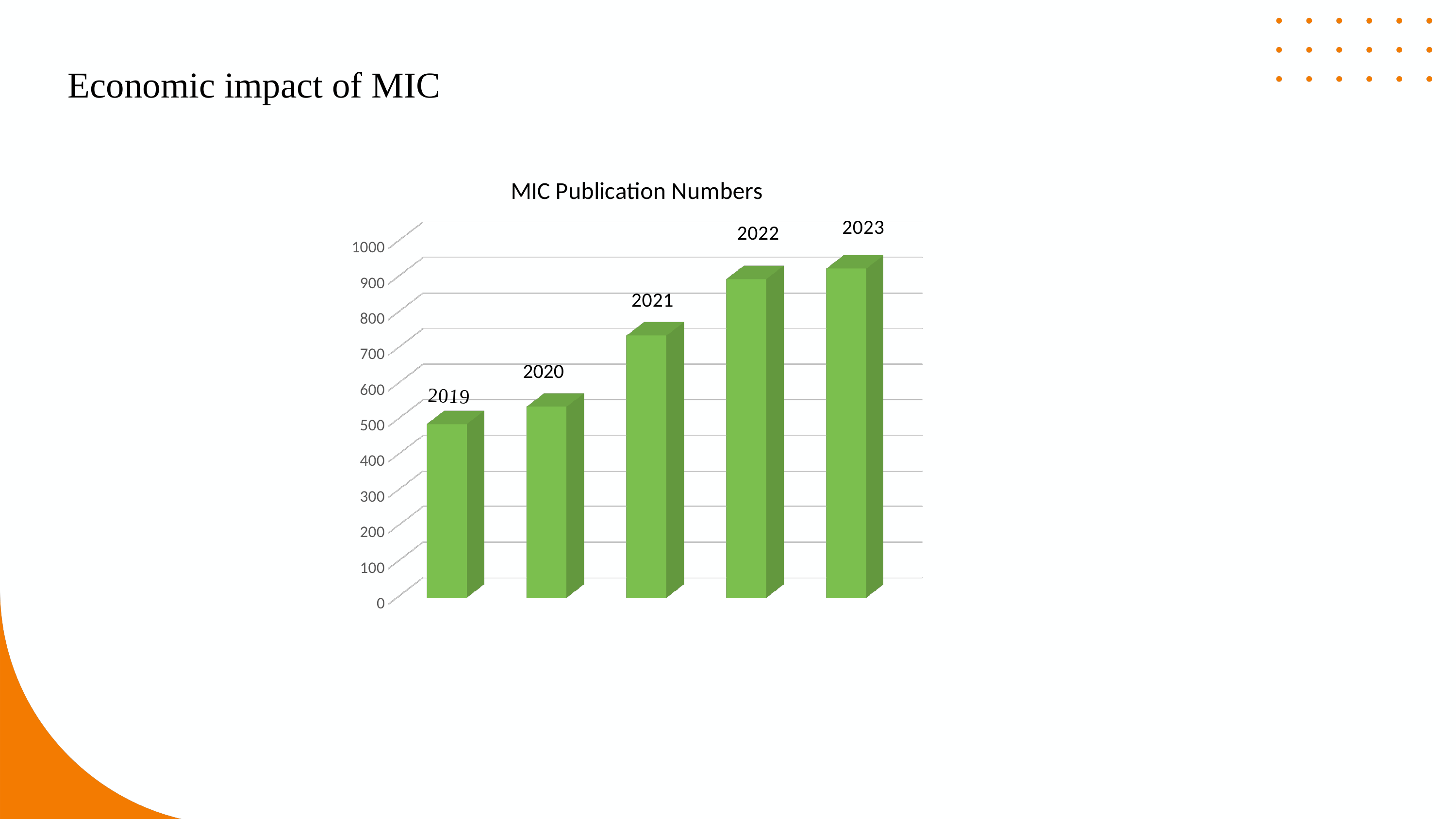
Is the value for 2020 greater or less than 700? less Which year has the highest number of MIC publications? 2023 Is the value for 2019 greater or less than 600? less Which year has the lowest number of MIC publications? 2019 Which year has more MIC publications, 2020 or 2021? 2021 Do the MIC publication numbers rise or fall from 2019 to 2023? rise What kind of chart is shown on the slide? bar chart How many years (bars) are plotted in the chart? 5 Is the value for 2022 greater or less than 700? greater What is the title of the chart? MIC Publication Numbers